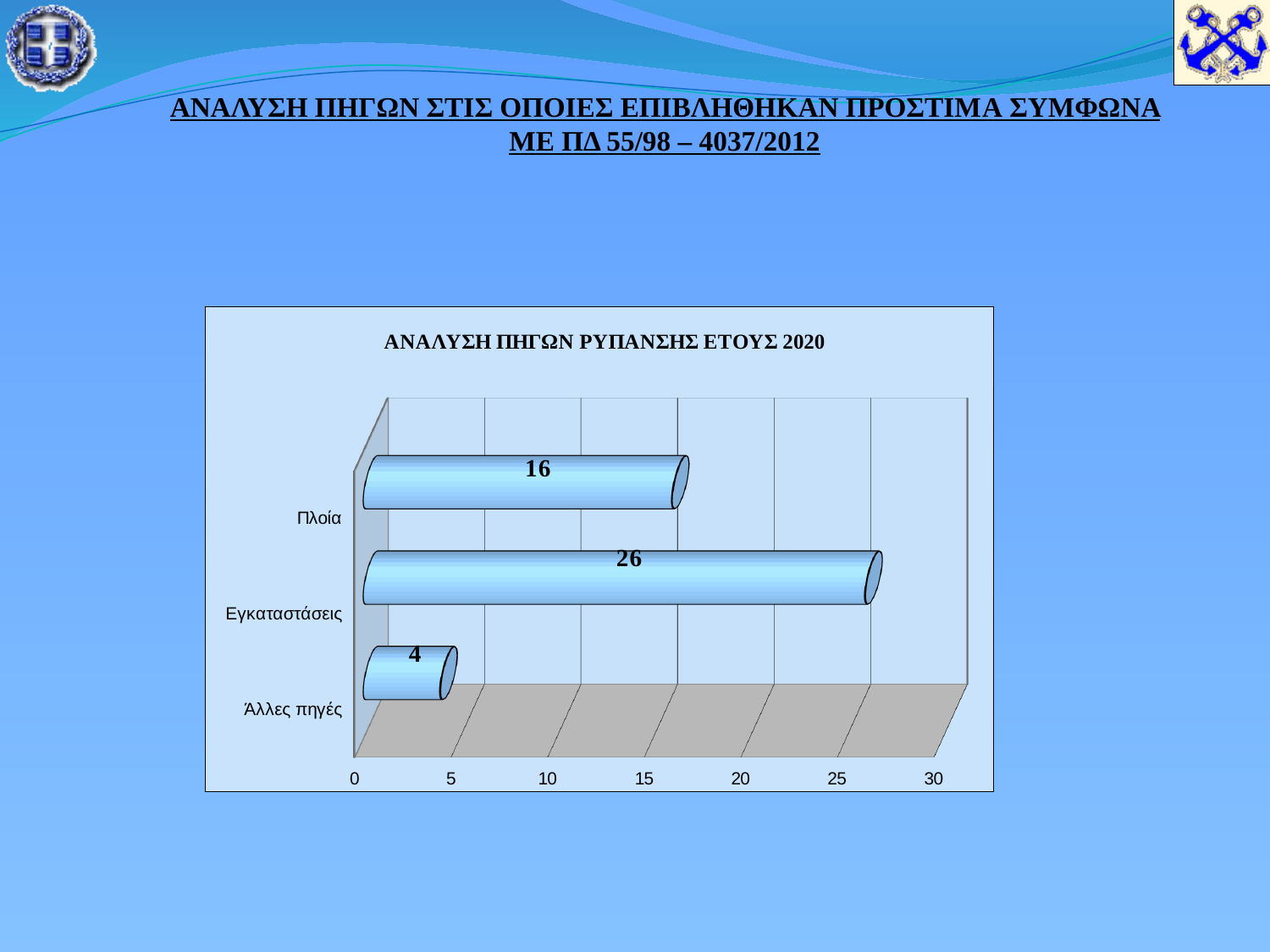
What is the value for Πλοία? 16 What is the maximum value shown on the horizontal axis? 30 Which is larger, the value for Πλοία or the value for Άλλες πηγές? Πλοία Which category has the lowest value? Άλλες πηγές What kind of chart is shown on the slide? bar chart How many categories are shown in the chart? 3 What is the title of the chart? ΑΝΑΛΥΣΗ ΠΗΓΩΝ ΡΥΠΑΝΣΗΣ ΕΤΟΥΣ 2020 Which category has the highest value? Εγκαταστάσεις What is the difference between the values for Εγκαταστάσεις and Πλοία? 10 Is the value for Εγκαταστάσεις greater or less than 20? greater What is the value for Εγκαταστάσεις? 26 What is the value for Άλλες πηγές? 4